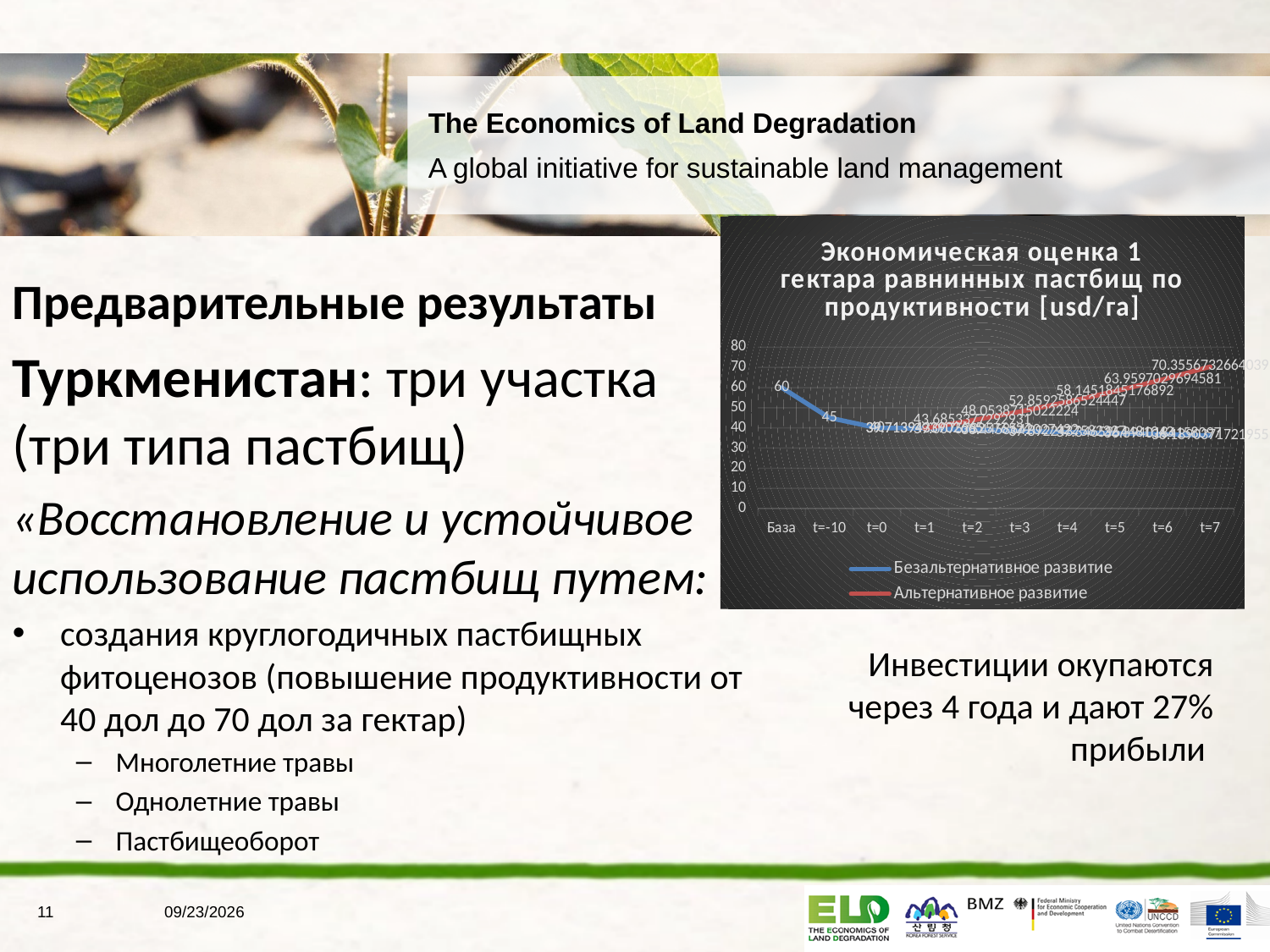
What kind of chart is shown on the slide? line chart Is the value of 'Безальтернативное развитие' at t=7 greater or less than 50? less What is the value at the 'База' point on the chart? 60 Which is larger, the value at 'База' or the value at 't=-10'? База How many categories are shown on the x axis of the chart? 10 What is the value at the 't=-10' point on the chart? 45 Does the 'Альтернативное развитие' series rise or fall from t=1 to t=7? rise What is the difference between the value at 'База' and the value at 't=-10'? 15 What is the unit given in the chart title? usd/га How many series does the chart legend list? 2 Is the value of 'Альтернативное развитие' at t=7 greater or less than 60? greater At which x-axis category does the 'Альтернативное развитие' series reach its highest value? t=7